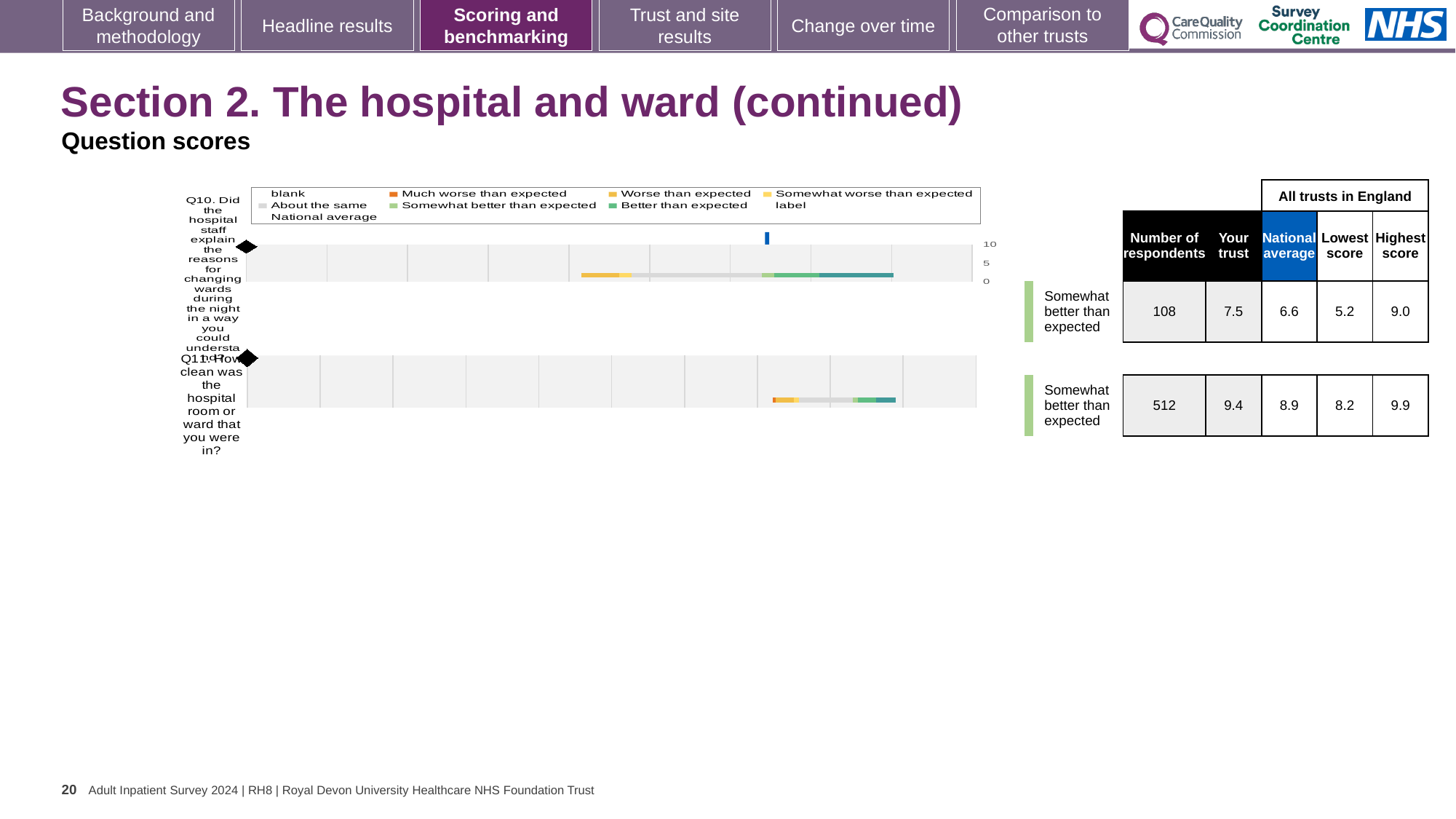
Which question has the higher 'Your trust' score, Q10 or Q11? Q11 For Q11 (how clean was the hospital room or ward), what is the 'Your trust' score? 9.4 What benchmark category is shown for both Q10 and Q11? Somewhat better than expected How many questions (Q10 and Q11) are plotted on the slide? 2 For Q11, what is the highest score among all trusts in England? 9.9 For Q10, what is the national average score? 6.6 For Q10 (explaining reasons for changing wards during the night), what is the 'Your trust' score? 7.5 How many entries does the legend above the Q10 chart list? 9 What kind of chart is used for the Q10 and Q11 question scores? bar chart For Q11, what is the difference between the 'Your trust' score and the national average? 0.5 For Q10, how many respondents are there? 108 What is the highest tick value shown on the axis of the Q10 chart? 10